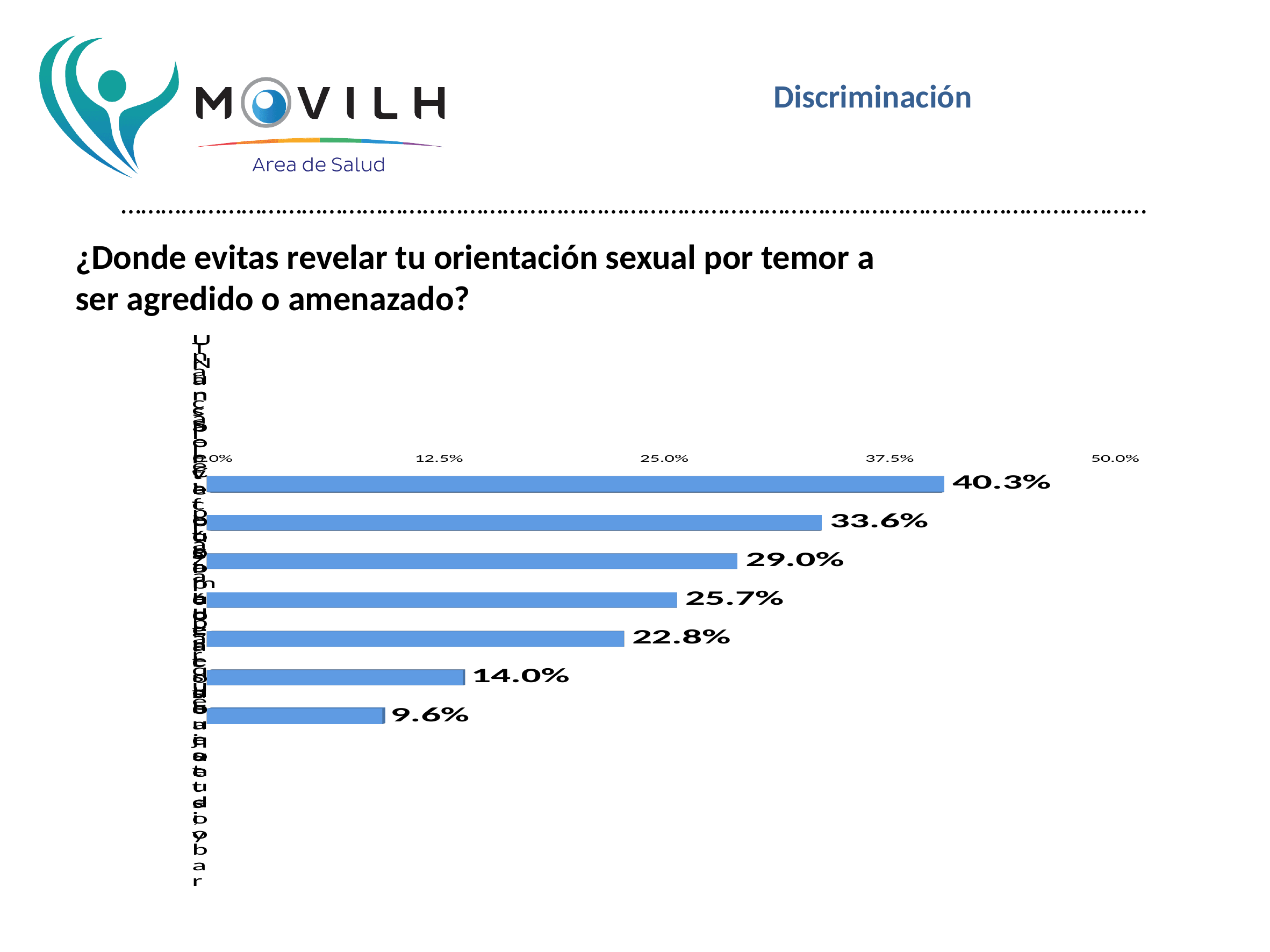
What is the difference between the top bar (40.3%) and the second bar from the top (33.6%)? 6.7% How many bars does the chart show? 7 Do the bar values increase or decrease going from the top bar to the bottom bar? decrease What value is labelled on the bottom bar of the chart? 9.6% What is the highest value shown on the horizontal axis of the chart? 50.0% Which is larger, the fourth bar from the top or the fifth bar from the top? the fourth bar from the top (25.7%) What kind of chart is shown on the slide? bar chart What value is labelled on the third bar from the top? 29.0% What value is labelled on the top bar of the chart? 40.3% What is the value of the shortest bar in the chart? 9.6% What is the difference between the bar labelled 14.0% and the bar labelled 9.6%? 4.4% What is the value of the longest bar in the chart? 40.3%